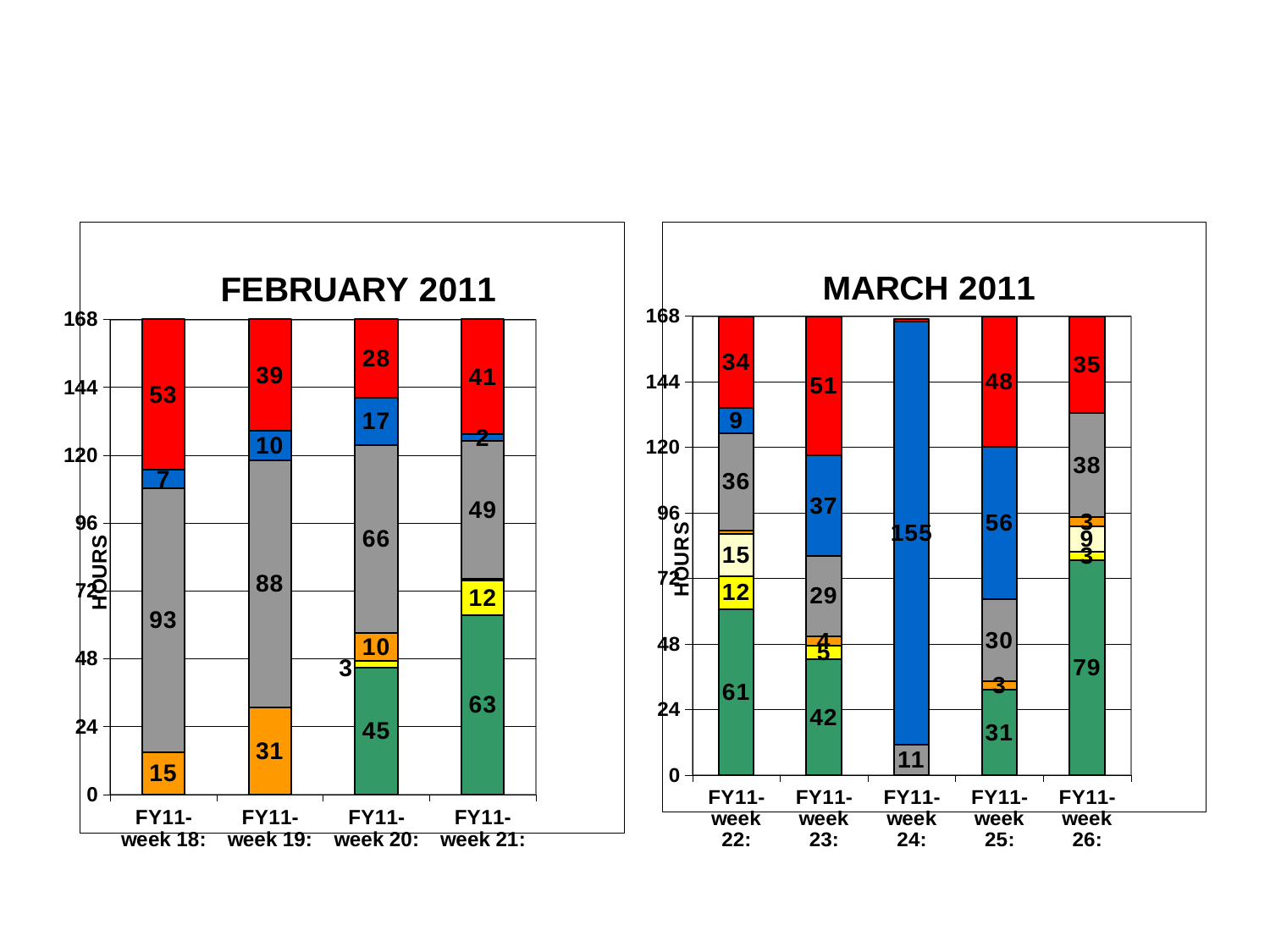
In the FEBRUARY 2011 chart, what is the value of the orange segment for FY11-week 18? 15 In the MARCH 2011 chart, what is the total of the stacked bar for FY11-week 25? 168 In the MARCH 2011 chart, what is the value of the blue segment for FY11-week 24? 155 In the MARCH 2011 chart, which week has the largest green (bottom) segment? FY11-week 26 In the FEBRUARY 2011 chart, what is the difference between the green segments of FY11-week 21 and FY11-week 20? 18 In the FEBRUARY 2011 chart, what is the value of the gray segment for FY11-week 19? 88 In the MARCH 2011 chart, which is larger: the red segment for FY11-week 23 or the red segment for FY11-week 22? FY11-week 23 How many bars (weeks) are shown in the MARCH 2011 chart? 5 What is the label on the vertical axis of the MARCH 2011 chart? HOURS How many bars (weeks) are shown in the FEBRUARY 2011 chart? 4 In the FEBRUARY 2011 chart, which week has the largest red (top) segment? FY11-week 18 What kind of chart is the FEBRUARY 2011 chart? stacked bar chart